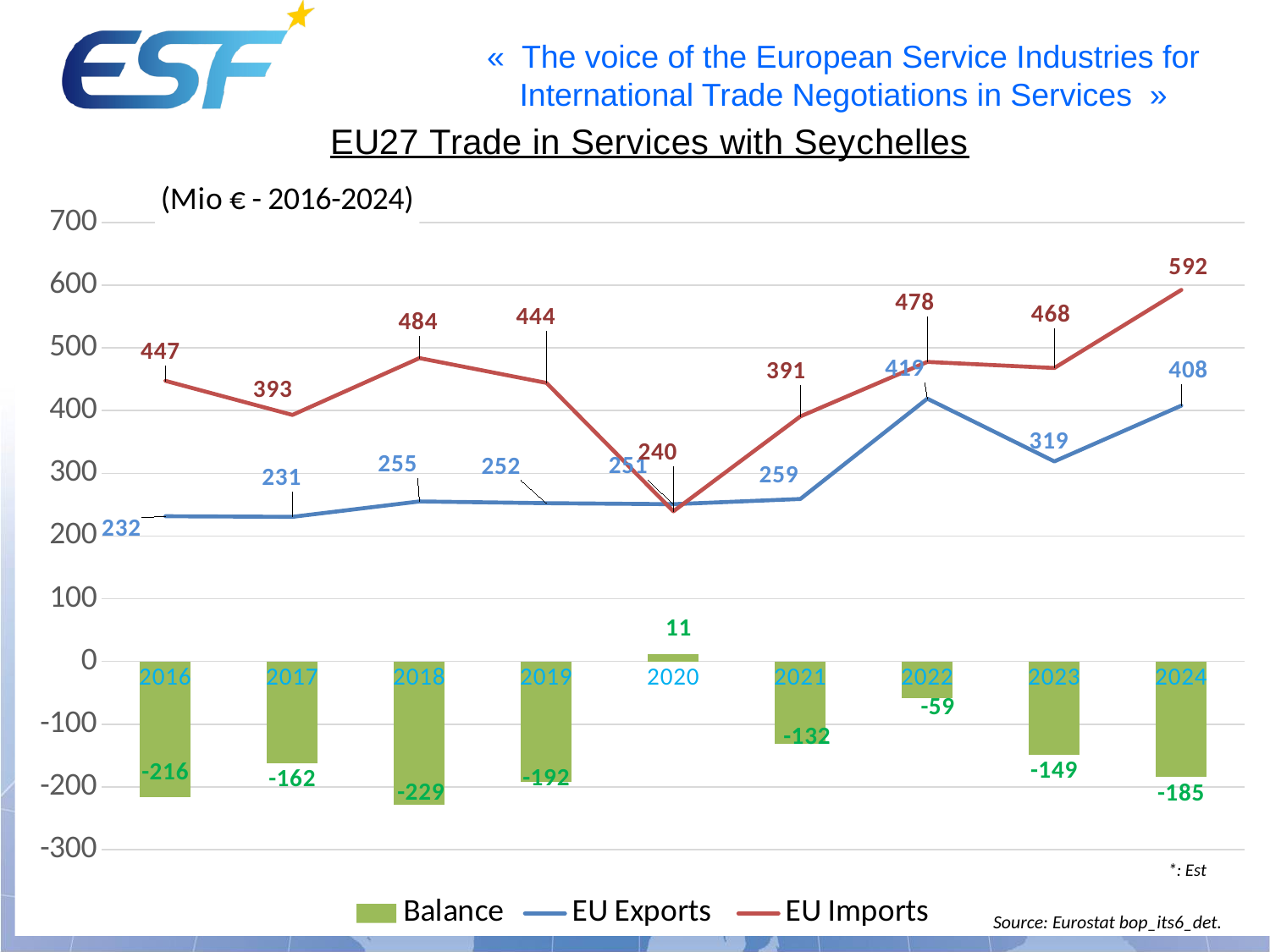
What is the Balance value for 2020? 11 Does the Balance rise or fall from 2018 to 2020? Rise What kind of chart is this? Combined bar and line chart Which year has higher EU Imports, 2018 or 2019? 2018 What is the difference between EU Imports in 2024 and EU Imports in 2023? 124 How many years are shown on the x axis? 9 How many series does the legend list? 3 In which year is the Balance most negative? 2018 What is the value of EU Imports in 2024? 592 What is the value of EU Exports in 2016? 232 In which year are EU Imports lowest? 2020 In which year are EU Imports highest? 2024